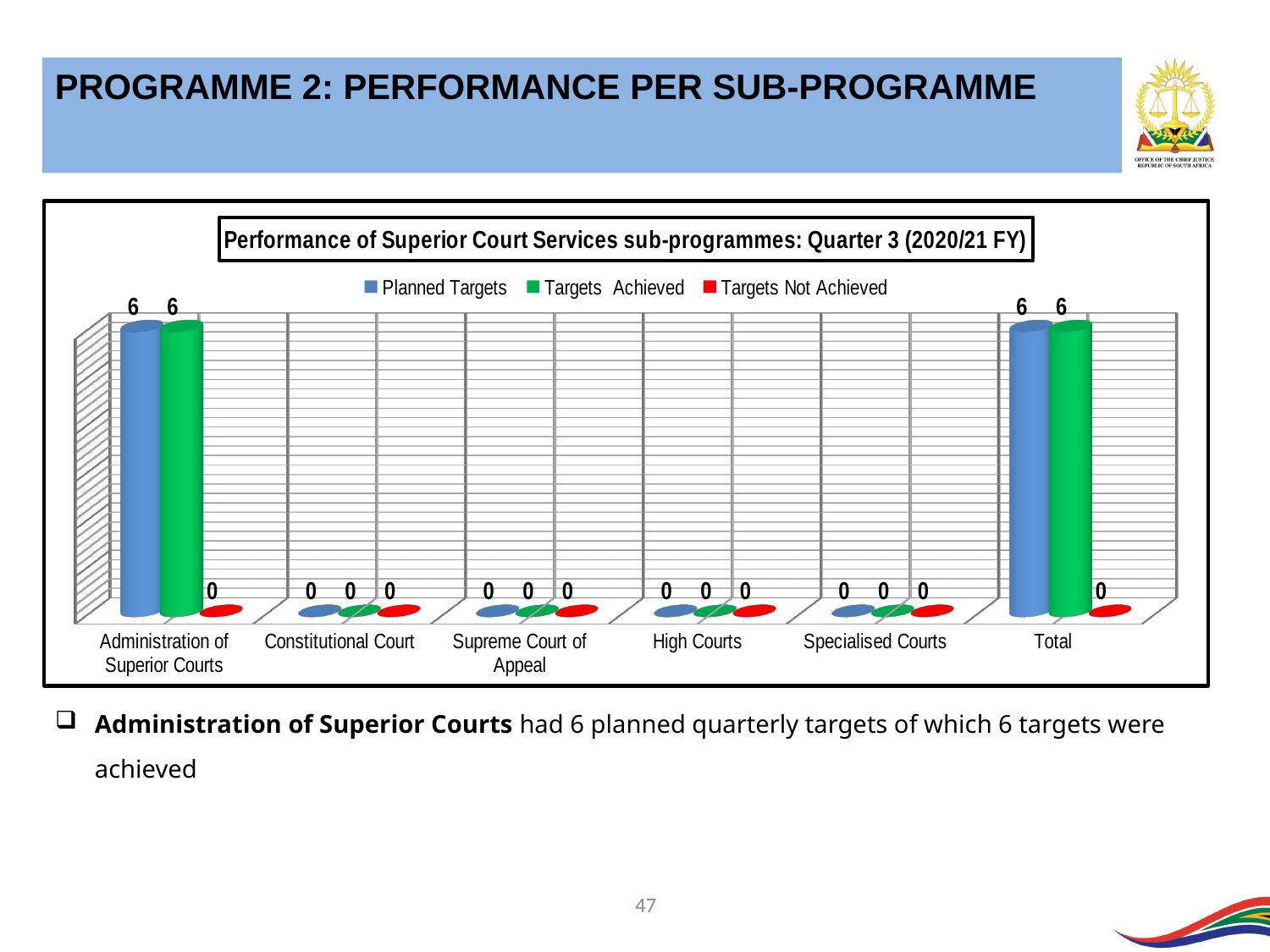
What is the Targets Achieved value for Total? 6 What is the Targets Achieved value for High Courts? 0 How many series does the legend list? 3 Which is larger: the Targets Achieved value for Administration of Superior Courts or for Supreme Court of Appeal? Administration of Superior Courts What is the Targets Not Achieved value for Total? 0 What kind of chart is shown on the slide? Bar chart How many categories are shown on the x axis? 6 What is the title of the chart? Performance of Superior Court Services sub-programmes: Quarter 3 (2020/21 FY) What is the Planned Targets value for Administration of Superior Courts? 6 What is the difference between the Planned Targets for Administration of Superior Courts and for Constitutional Court? 6 Which category has the highest Planned Targets value, excluding Total? Administration of Superior Courts What is the difference between Planned Targets and Targets Achieved for Administration of Superior Courts? 0